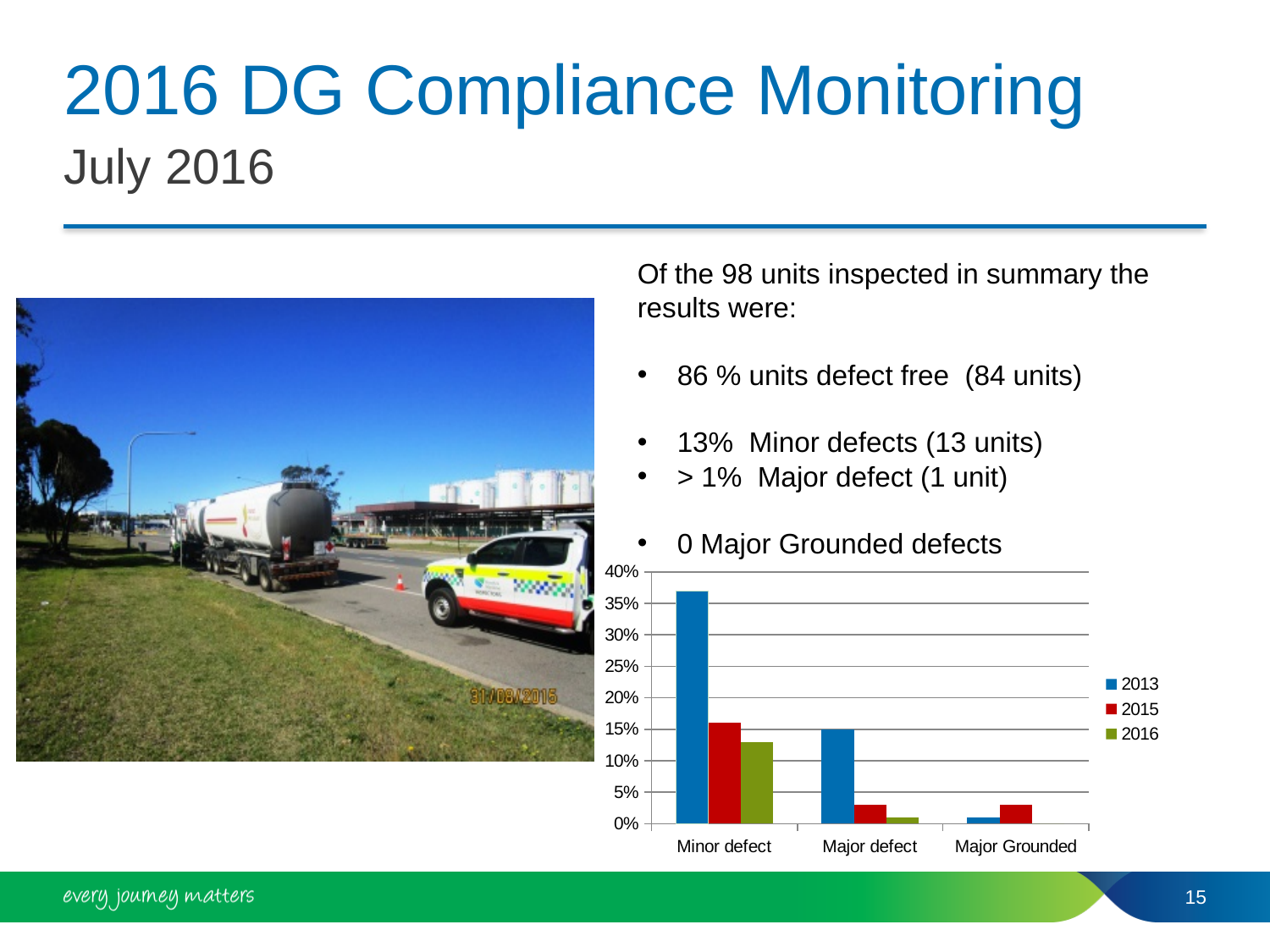
What kind of chart is shown on the slide? bar chart Which category has the lowest value for the 2013 series? Major Grounded Is the 2016 value for Major defect greater or less than 5%? less How many series does the chart legend list? 3 What colour represents the 2016 series in the chart legend? green Is the 2015 value for Minor defect greater or less than 20%? less Which year has the highest value for Minor defect? 2013 How many defect categories are shown on the x axis of the chart? 3 For Minor defect, which year has the larger value, 2013 or 2015? 2013 For Major Grounded, which year has the larger value, 2013 or 2015? 2015 Is the 2013 value for Minor defect greater or less than 30%? greater